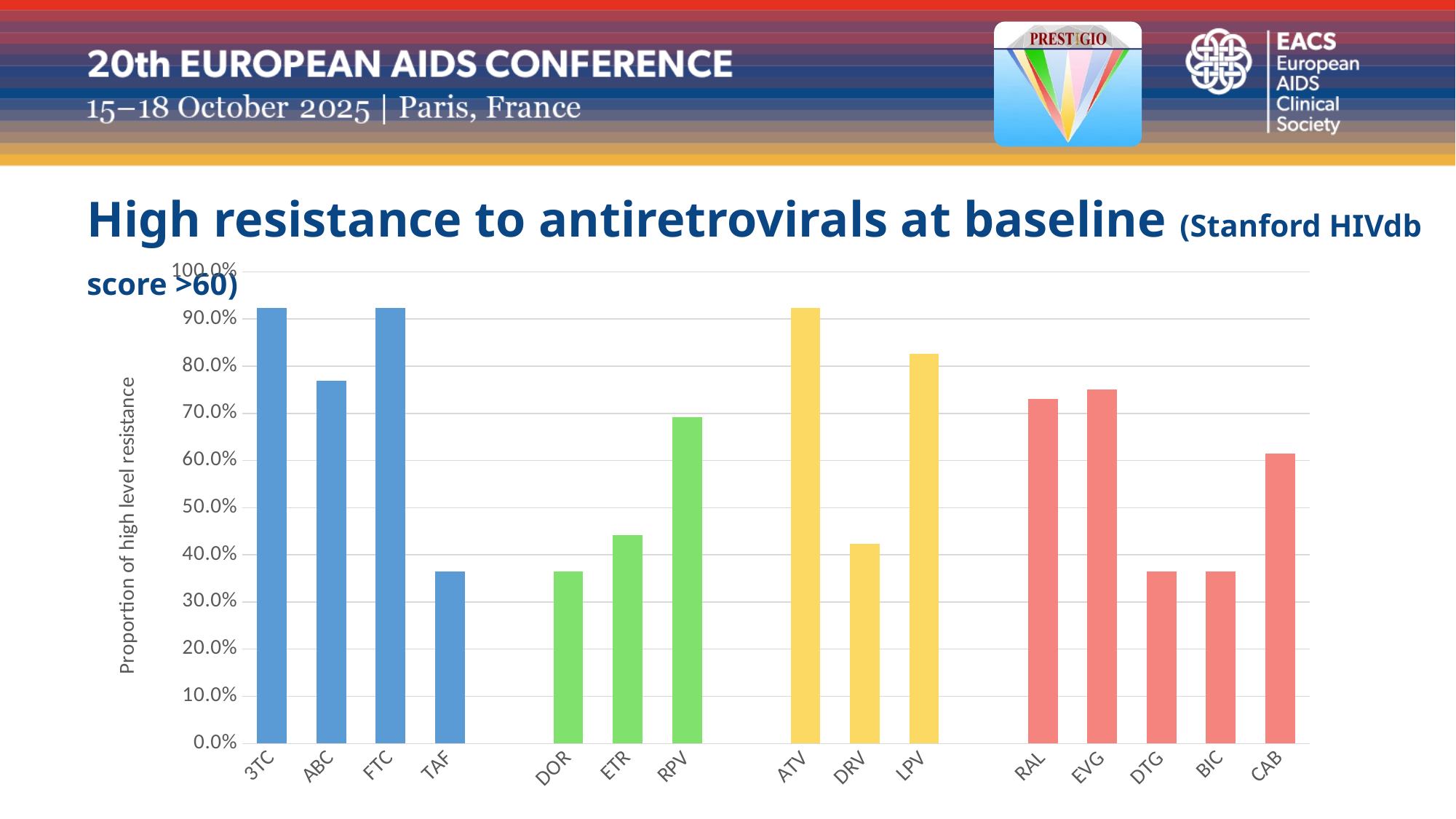
Which has a higher proportion of high level resistance, LPV or DRV? LPV Is the value for CAB greater or less than 70.0%? less What kind of chart is shown on the slide? bar chart What is the label on the vertical axis of the chart? Proportion of high level resistance Is the value for RPV greater or less than 60.0%? greater Is the value for TAF greater or less than 40.0%? less How many drugs (bars) are plotted on the chart? 15 Which has a higher proportion of high level resistance, 3TC or ABC? 3TC Which has a higher proportion of high level resistance, CAB or DTG? CAB